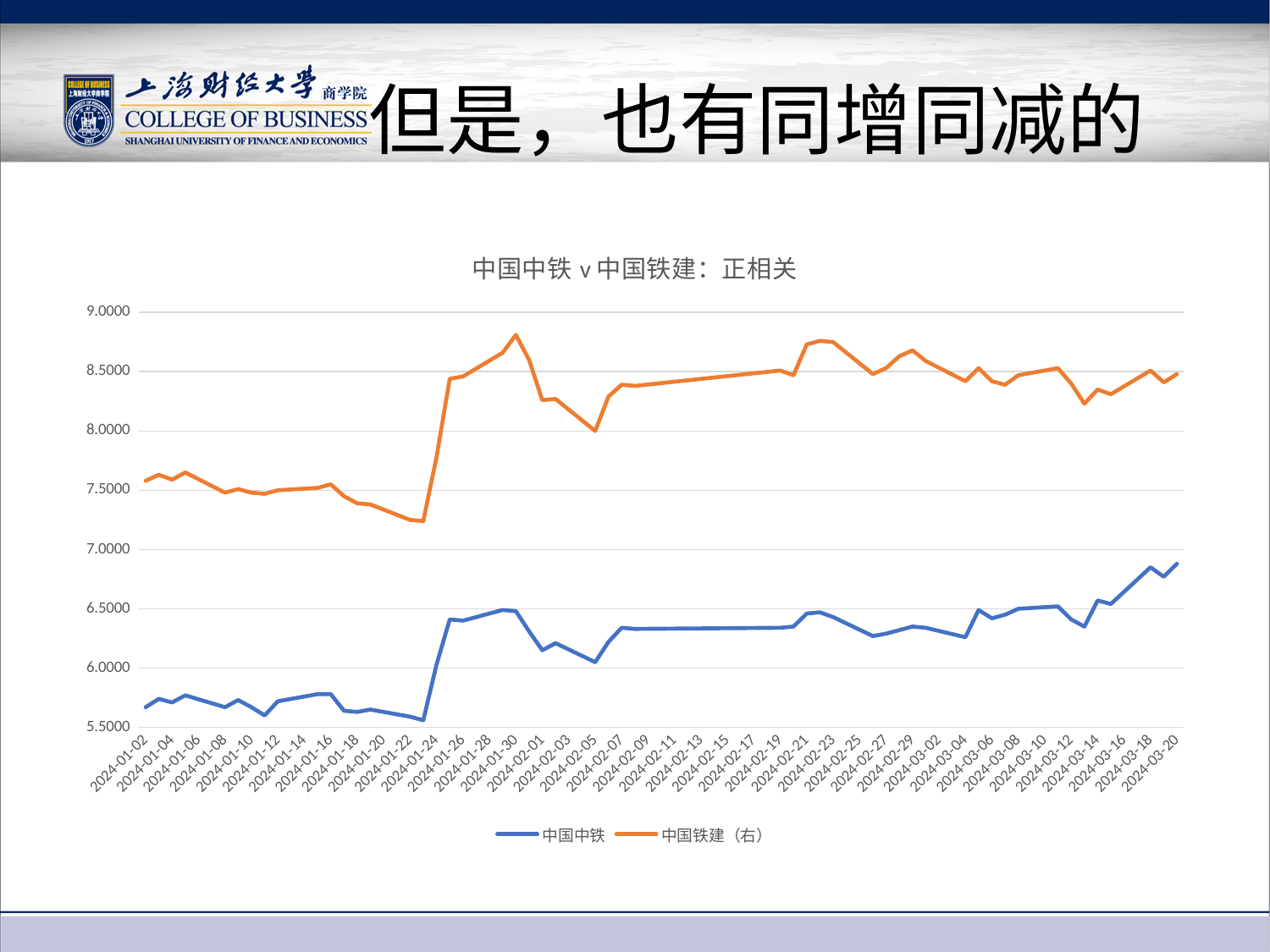
Is the value for 中国铁建 on 2024-01-30 greater or less than 8.5000? greater Which colour is used for the 中国中铁 line? blue On which date does the 中国铁建 line reach its highest value? 2024-01-30 What kind of chart is shown on the slide? line chart How many series does the legend list? 2 Is the value for 中国中铁 on 2024-01-02 greater or less than 6.0000? less Is the value for 中国铁建 on 2024-01-24 greater or less than 7.5000? greater What is the title of the chart? 中国中铁 v 中国铁建：正相关 Overall, does the 中国中铁 line rise or fall from 2024-01-02 to 2024-03-20? rise On 2024-02-01, which series has the higher value, 中国中铁 or 中国铁建? 中国铁建